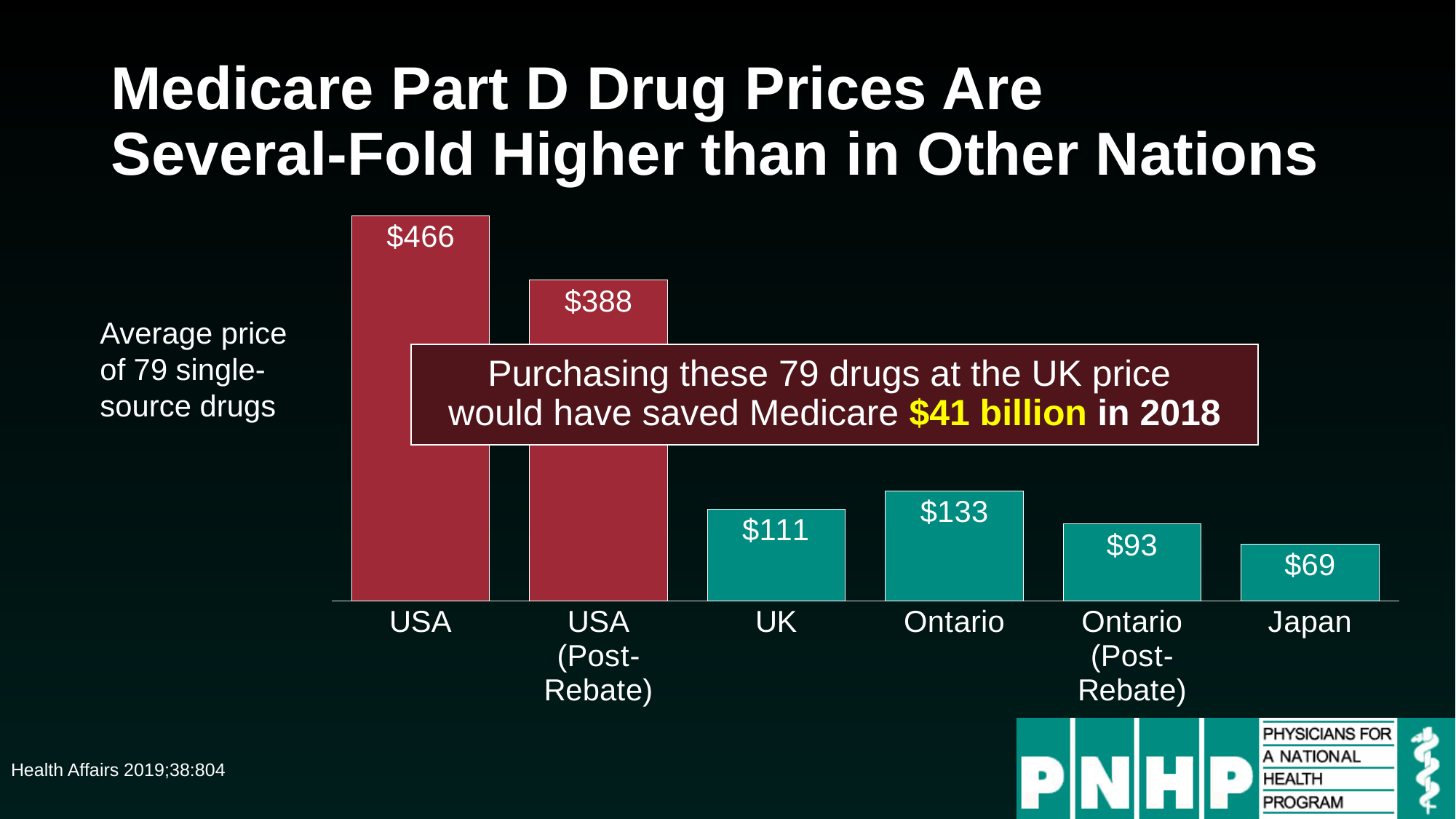
What is the difference between the Ontario price and the Ontario (Post-Rebate) price? $40 How many categories are shown on the chart? 6 What kind of chart is shown on the slide? Bar chart What is the difference between the USA price and the UK price? $355 Which category has the highest average price? USA Which is larger, the price for Ontario or the price for the UK? Ontario What is the average price shown for Japan? $69 What is the average price shown for the UK? $111 According to the text box on the chart, how much would Medicare have saved in 2018 by purchasing these drugs at the UK price? $41 billion Which category has the lowest average price? Japan What is the average price shown for USA (Post-Rebate)? $388 What is the average price shown for the USA? $466